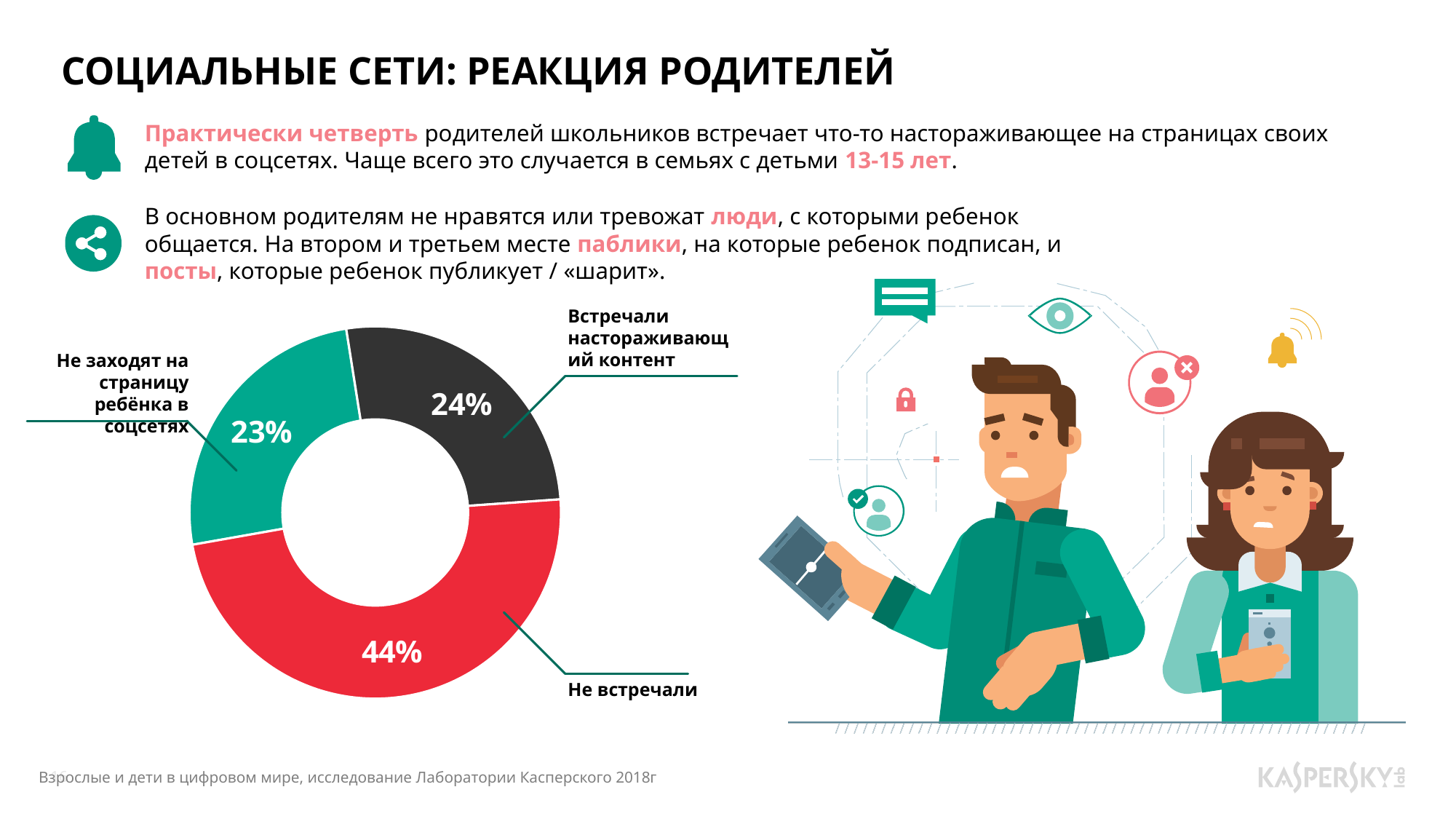
What percentage of parents "Не заходят на страницу ребёнка в соцсетях"? 23% Which is larger: the share for "Не встречали" or the share for "Не заходят на страницу ребёнка в соцсетях"? Не встречали What percentage of parents "Не встречали" alarming content? 44% What colour is the slice for "Встречали настораживающий контент"? Black What colour is the slice for "Не встречали"? Red What percentage of parents "Встречали настораживающий контент"? 24% What is the difference in percentage points between "Не встречали" and "Встречали настораживающий контент"? 20 Which category has the smallest share in the donut chart? Не заходят на страницу ребёнка в соцсетях Which category has the largest share in the donut chart? Не встречали How many categories (slices) does the donut chart have? 3 What type of chart is shown on the slide? Donut (pie) chart What is the difference in percentage points between "Встречали настораживающий контент" and "Не заходят на страницу ребёнка в соцсетях"? 1